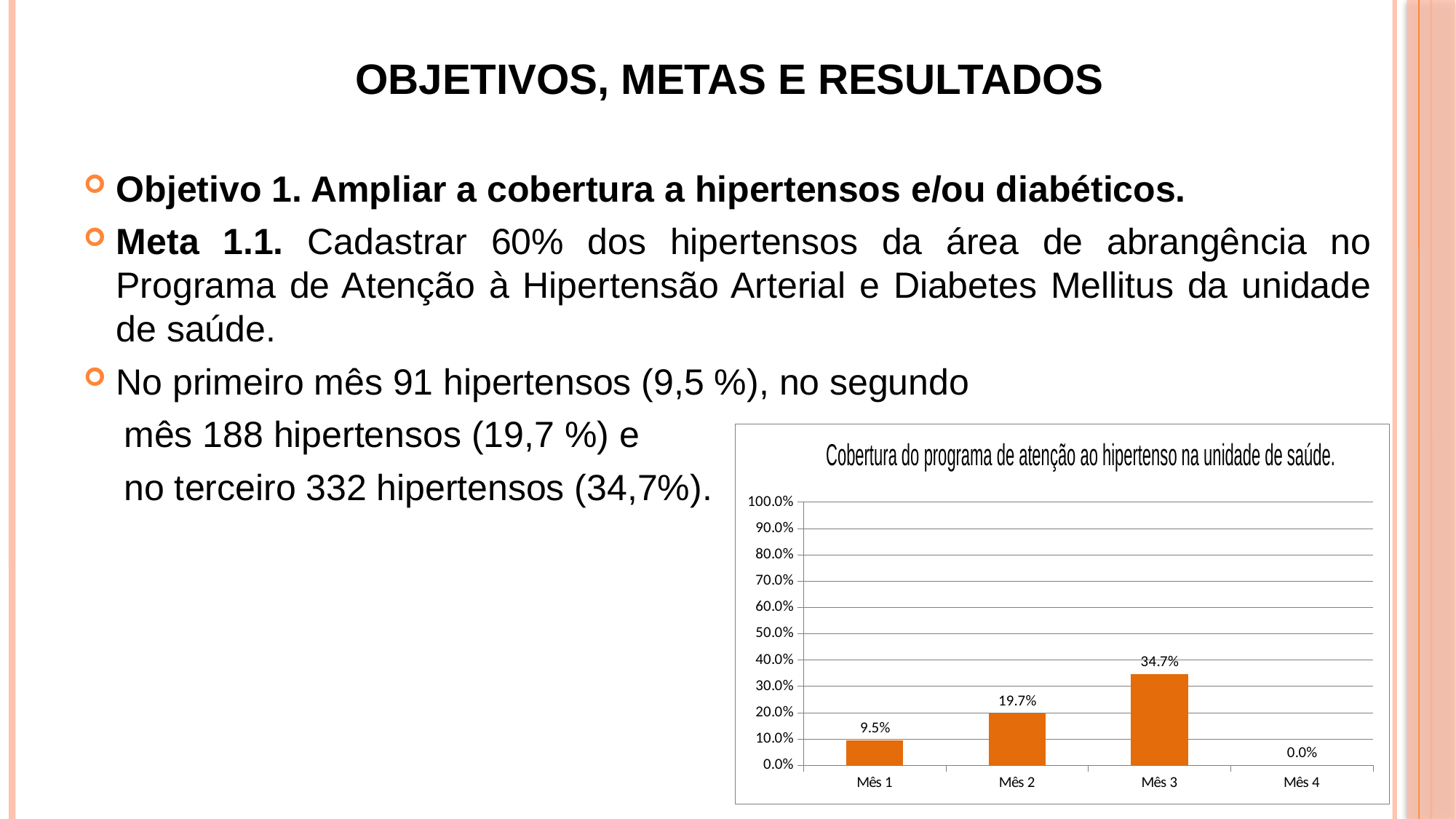
Which is larger, the value for Mês 1 or the value for Mês 2? Mês 2 What is the value for Mês 4? 0.0% What is the value for Mês 1? 9.5% Which month has the lowest value? Mês 4 Is the value for Mês 3 greater or less than 30.0%? greater What is the value for Mês 2? 19.7% What is the title of the chart? Cobertura do programa de atenção ao hipertenso na unidade de saúde. What is the difference between the values for Mês 3 and Mês 2? 15.0% What kind of chart is shown? bar chart How many months are shown on the x axis? 4 Which month has the highest value? Mês 3 What is the value for Mês 3? 34.7%